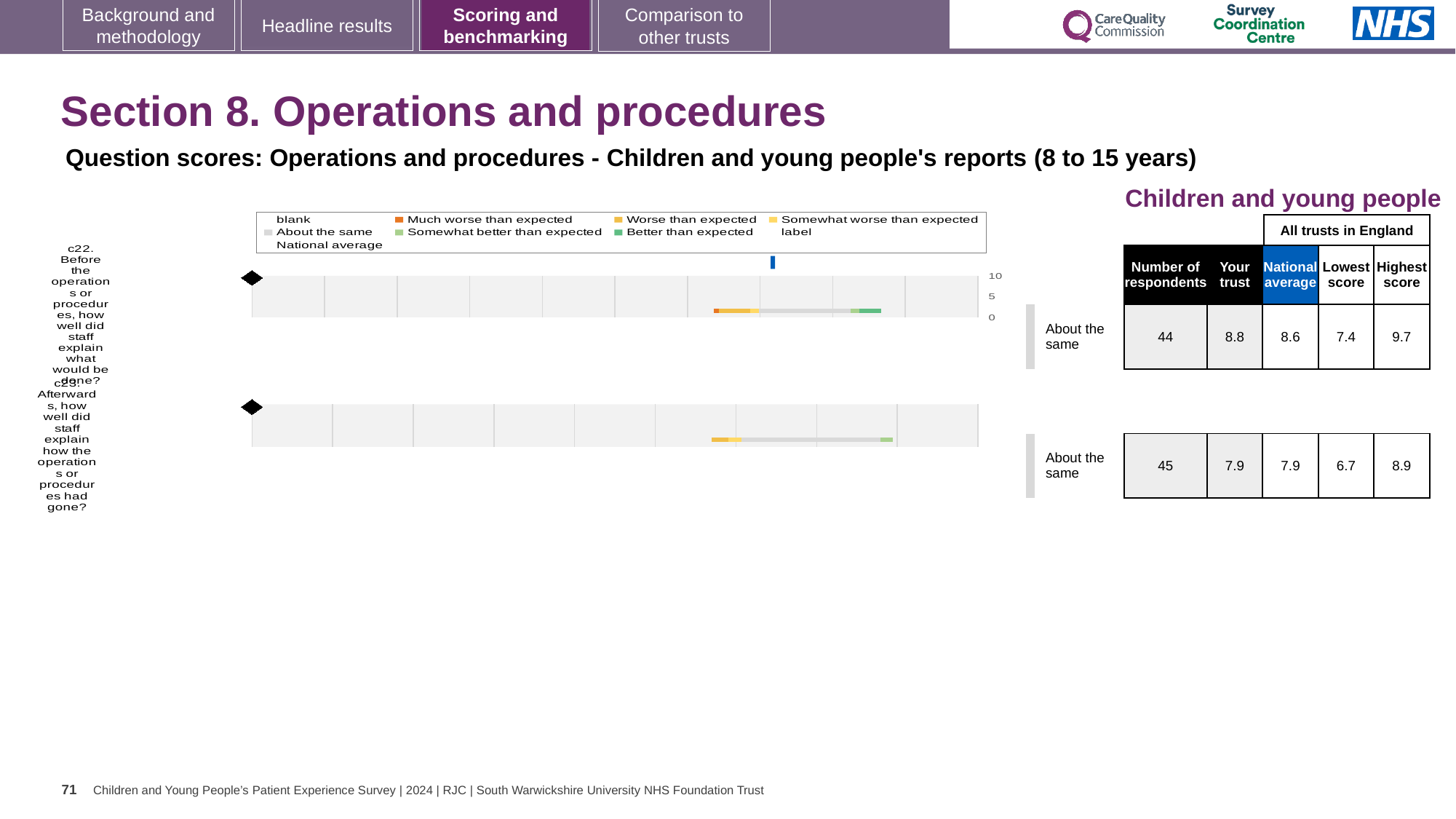
What kind of chart is used to show the benchmarking result for question c22? bar chart For question c22, which is larger: the 'Your trust' score or the National average? Your trust For question c23, what is the difference between the Highest score and the Lowest score? 2.2 In the table beside the c23 chart, what is the National average score? 7.9 How many respondents are listed for question c22? 44 What is the Lowest score listed for question c23? 6.7 Which question has the higher 'Your trust' score, c22 or c23? c22 For question c22, what is the difference between the Highest score and the Lowest score? 2.3 In the table beside the c22 chart, what is the 'Your trust' score? 8.8 What benchmark category is shown next to the c22 chart? About the same Which colour does the legend use for 'Much worse than expected'? orange How many question charts (c22 and c23) are plotted on the slide? 2